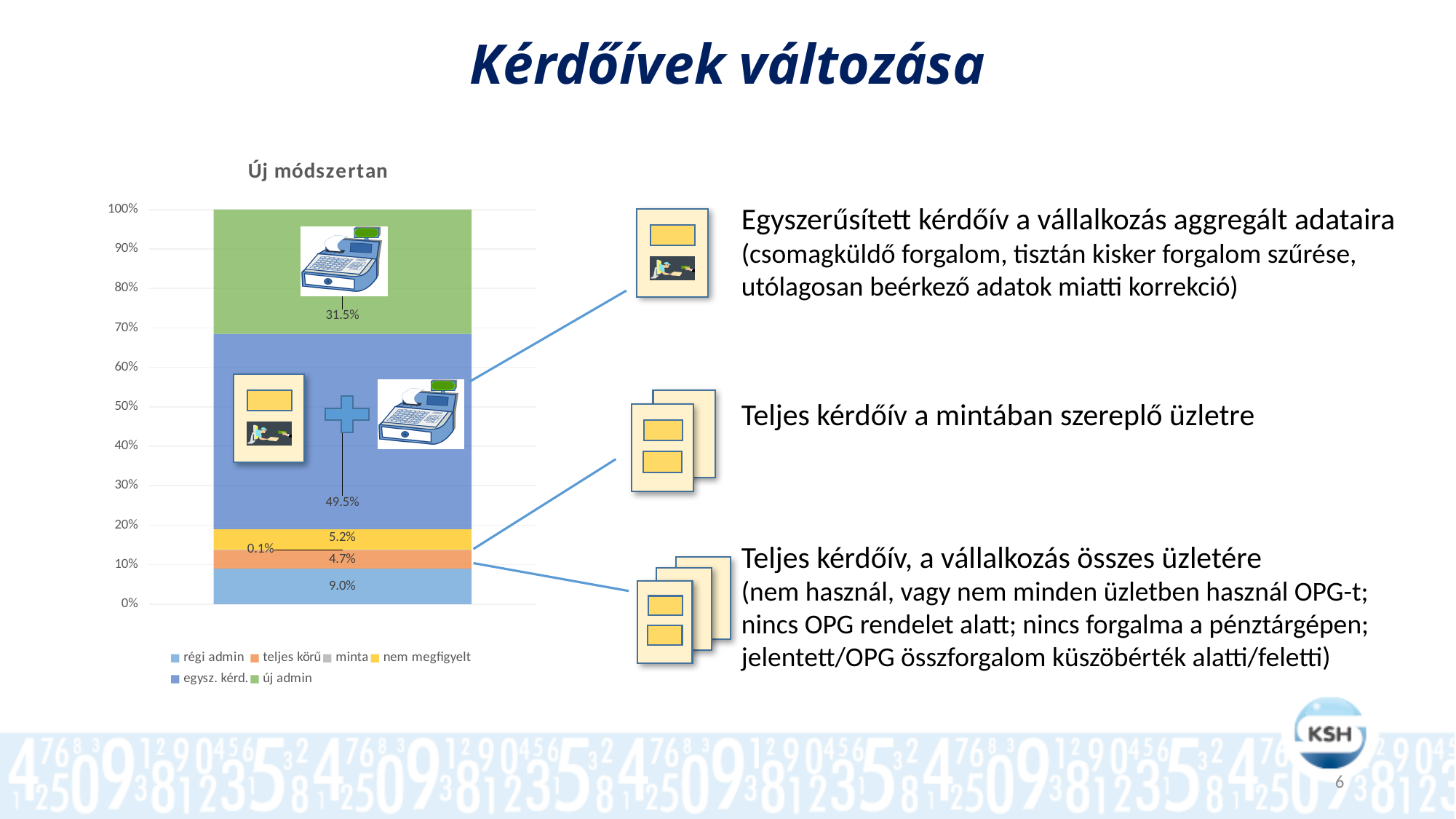
What is the value of the 'új admin' segment? 31.5% What is the combined value of 'régi admin' and 'teljes körű'? 13.7% Which is larger, 'nem megfigyelt' or 'teljes körű'? nem megfigyelt Which series has the largest share of the stacked bar? egysz. kérd. How many series does the chart legend list? 6 What is the value of the 'minta' segment? 0.1% What is the difference between the 'egysz. kérd.' and 'új admin' values? 18.0% What is the title of the chart? Új módszertan What kind of chart is shown on the slide? stacked bar chart Which series has the smallest share of the stacked bar? minta What is the value of the 'régi admin' segment? 9.0% What is the value of the 'egysz. kérd.' segment? 49.5%